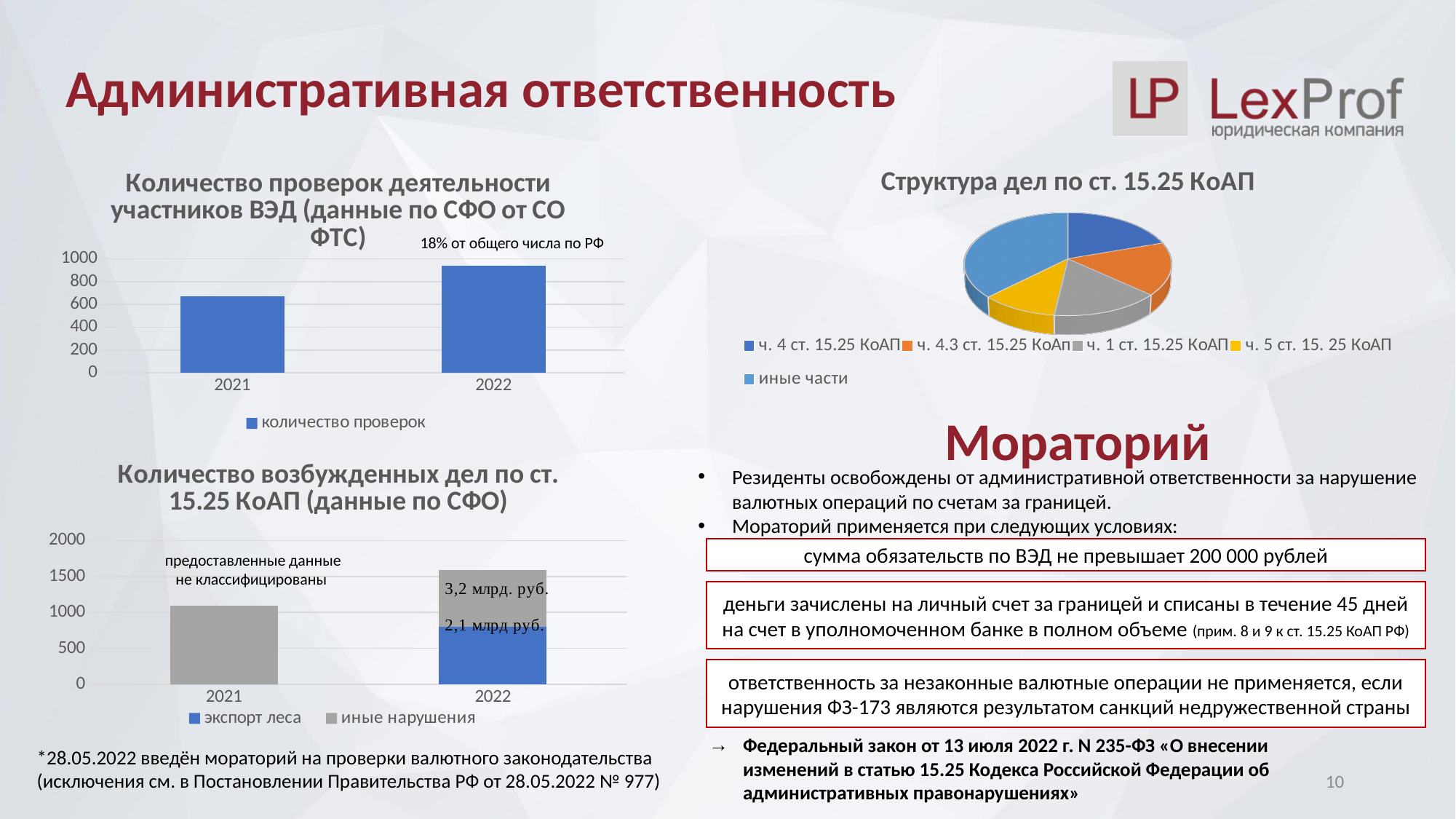
In the chart "Структура дел по ст. 15.25 КоАП", which category has the largest slice? иные части In the chart "Количество проверок деятельности участников ВЭД", is the value for 2022 greater or less than 1000? less How many categories does the legend of the chart "Структура дел по ст. 15.25 КоАП" list? 5 What kind of chart is "Структура дел по ст. 15.25 КоАП"? pie chart What kind of chart is "Количество проверок деятельности участников ВЭД (данные по СФО от СО ФТС)"? bar chart In the chart "Количество проверок деятельности участников ВЭД", is the value for 2021 greater or less than 600? greater In the chart "Количество проверок деятельности участников ВЭД", do the values rise or fall from 2021 to 2022? rise In the chart "Количество проверок деятельности участников ВЭД", what share of the total for the Russian Federation does the 2022 bar represent, according to the annotation? 18% от общего числа по РФ In the chart "Количество возбужденных дел по ст. 15.25 КоАП (данные по СФО)", which series is shown in blue? экспорт леса In the chart "Количество возбужденных дел по ст. 15.25 КоАП (данные по СФО)", is the total for 2021 greater or less than 1000? greater How many series does the legend of the chart "Количество возбужденных дел по ст. 15.25 КоАП (данные по СФО)" list? 2 In the chart "Количество проверок деятельности участников ВЭД", which year has the higher number of inspections? 2022